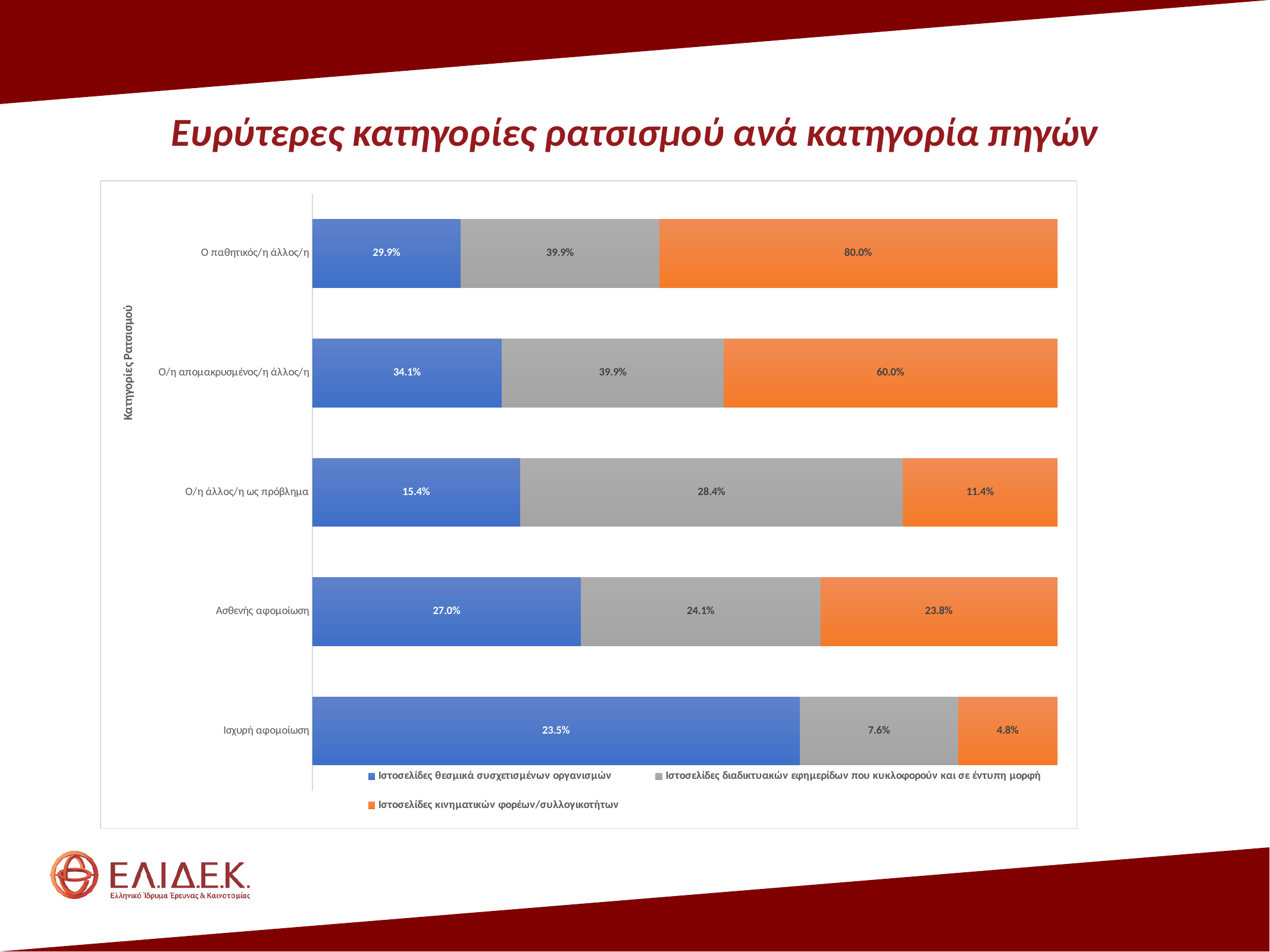
What is the difference between the Ιστοσελίδες κινηματικών φορέων/συλλογικοτήτων values for Ο παθητικός/η άλλος/η and Ο/η απομακρυσμένος/η άλλος/η? 20.0% Which category has the lowest value in the Ιστοσελίδες διαδικτυακών εφημερίδων που κυκλοφορούν και σε έντυπη μορφή series? Ισχυρή αφομοίωση How many categories of racism are shown on the y axis? 5 What is the value for Ο/η άλλος/η ως πρόβλημα in the Ιστοσελίδες διαδικτυακών εφημερίδων που κυκλοφορούν και σε έντυπη μορφή series? 28.4% How many series does the legend list? 3 What is the value for Ισχυρή αφομοίωση in the Ιστοσελίδες θεσμικά συσχετισμένων οργανισμών series? 23.5% For Ασθενής αφομοίωση, which series has the larger value: Ιστοσελίδες θεσμικά συσχετισμένων οργανισμών or Ιστοσελίδες διαδικτυακών εφημερίδων που κυκλοφορούν και σε έντυπη μορφή? Ιστοσελίδες θεσμικά συσχετισμένων οργανισμών Which category has the highest value in the Ιστοσελίδες θεσμικά συσχετισμένων οργανισμών series? Ο/η απομακρυσμένος/η άλλος/η What is the title of the slide? Ευρύτερες κατηγορίες ρατσισμού ανά κατηγορία πηγών What is the value for Ο παθητικός/η άλλος/η in the Ιστοσελίδες κινηματικών φορέων/συλλογικοτήτων series? 80.0% What kind of chart is shown on the slide? Stacked bar chart Which category has the highest value in the Ιστοσελίδες κινηματικών φορέων/συλλογικοτήτων series? Ο παθητικός/η άλλος/η